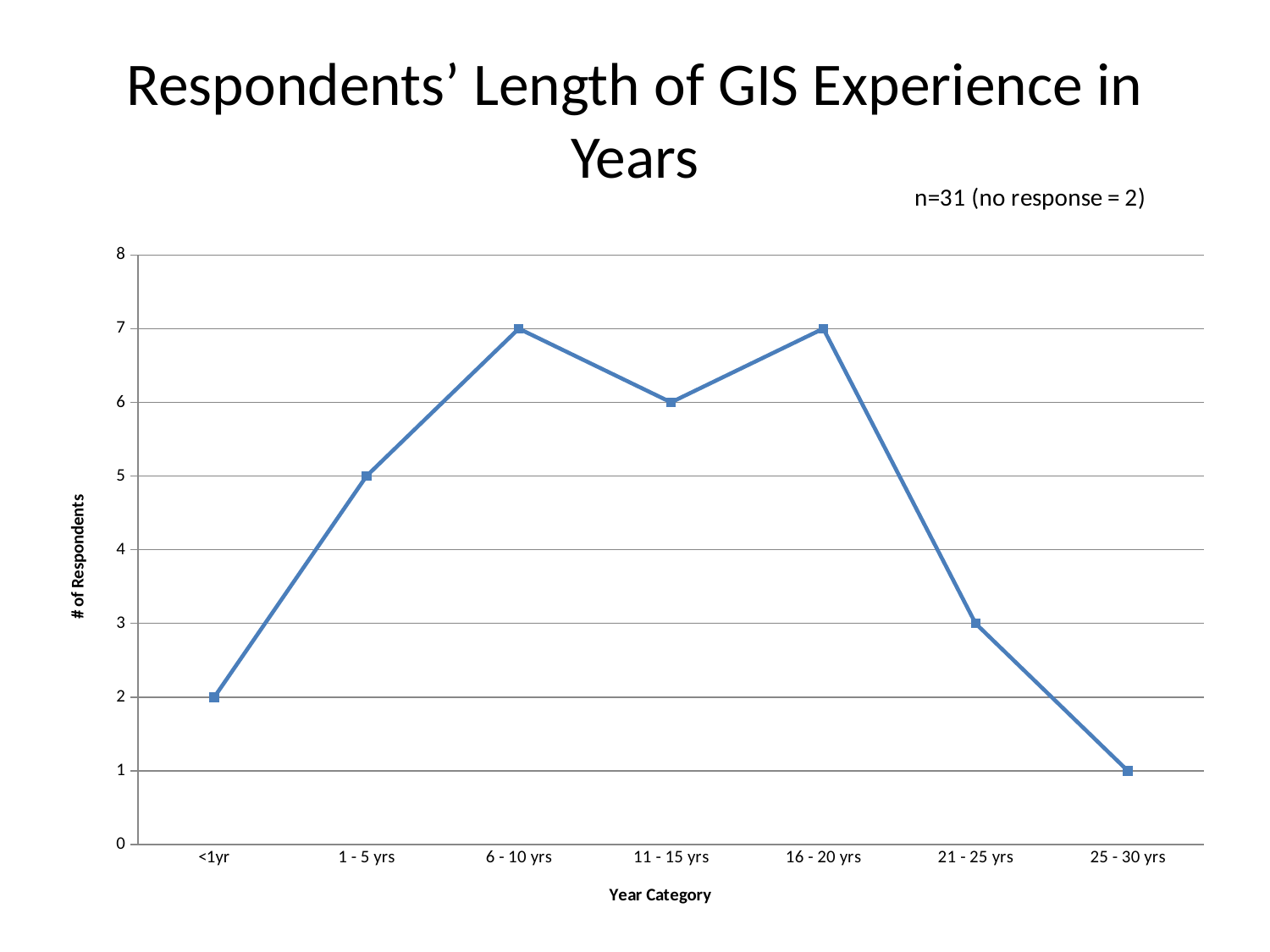
Does the number of respondents rise or fall from the 16 - 20 yrs category to the 25 - 30 yrs category? Fall What is the number of respondents for the 1 - 5 yrs category? 5 What is the number of respondents for the 11 - 15 yrs category? 6 Which has more respondents, the 1 - 5 yrs category or the 11 - 15 yrs category? 11 - 15 yrs Which year category has the lowest number of respondents? 25 - 30 yrs How many respondents reported less than 1 year of GIS experience (<1yr)? 2 What kind of chart is shown on the slide? Line chart What is the number of respondents for the 21 - 25 yrs category? 3 What is the label of the y axis? # of Respondents What is the difference in number of respondents between the 6 - 10 yrs and 21 - 25 yrs categories? 4 Is the number of respondents for the 16 - 20 yrs category greater or less than 5? greater How many year categories are plotted on the x axis? 7